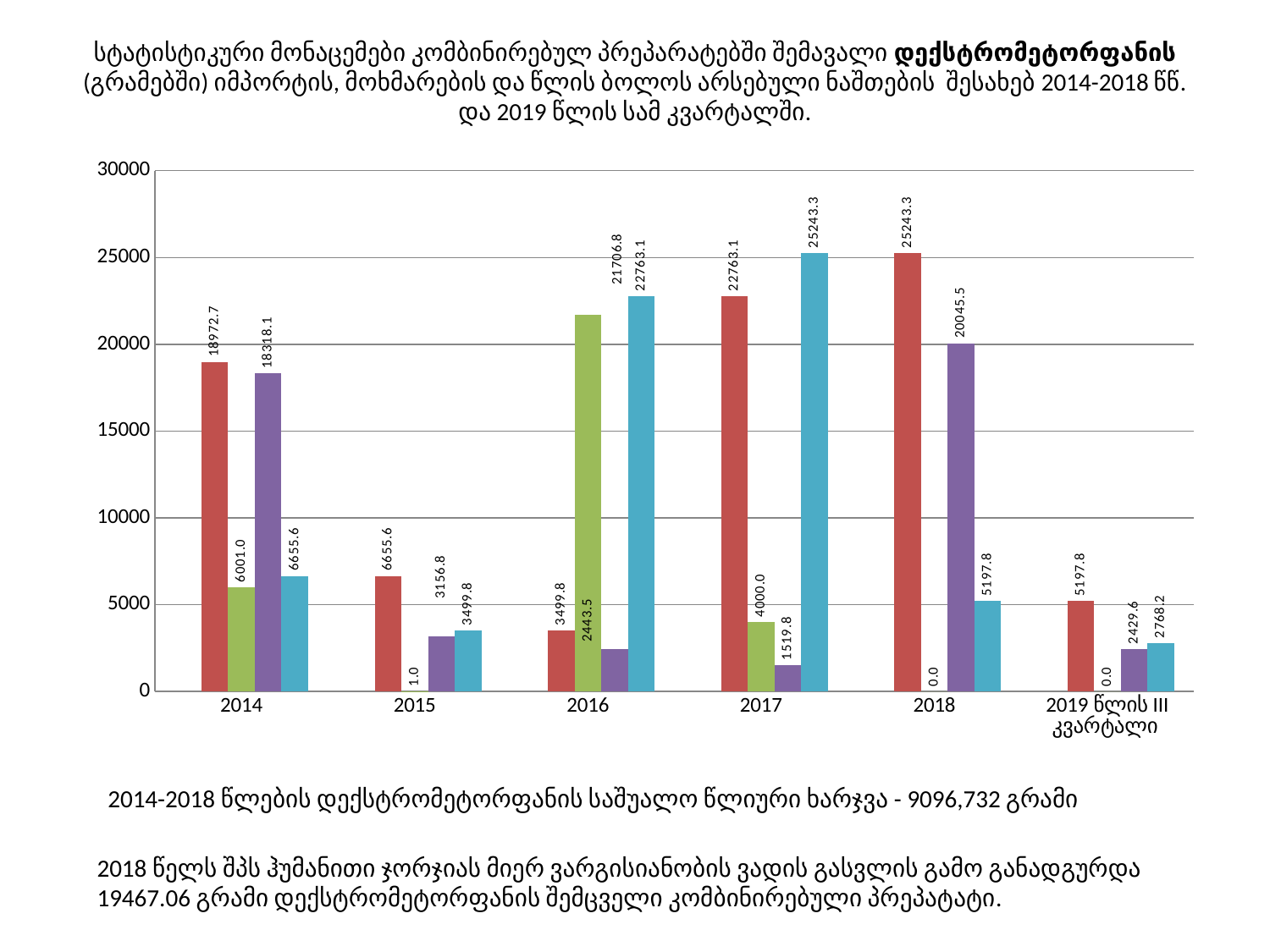
Which is larger for 2014, the red bar or the purple bar? the red bar Which category has the lowest blue bar? 2019 წლის III კვარტალი How many categories are shown on the x axis of the chart? 6 What is the difference between the blue bar and the red bar for 2017? 2480.2 What is the value of the green bar for 2015? 1.0 What is the value of the purple bar for 2018? 20045.5 What is the value of the red bar for 2014? 18972.7 What is the value of the blue bar for 2017? 25243.3 What kind of chart is shown on the slide? bar chart What is the value of the green bar for 2016? 21706.8 Is the value of the purple bar for 2016 greater or less than 5000? less Which category has the highest red bar? 2018